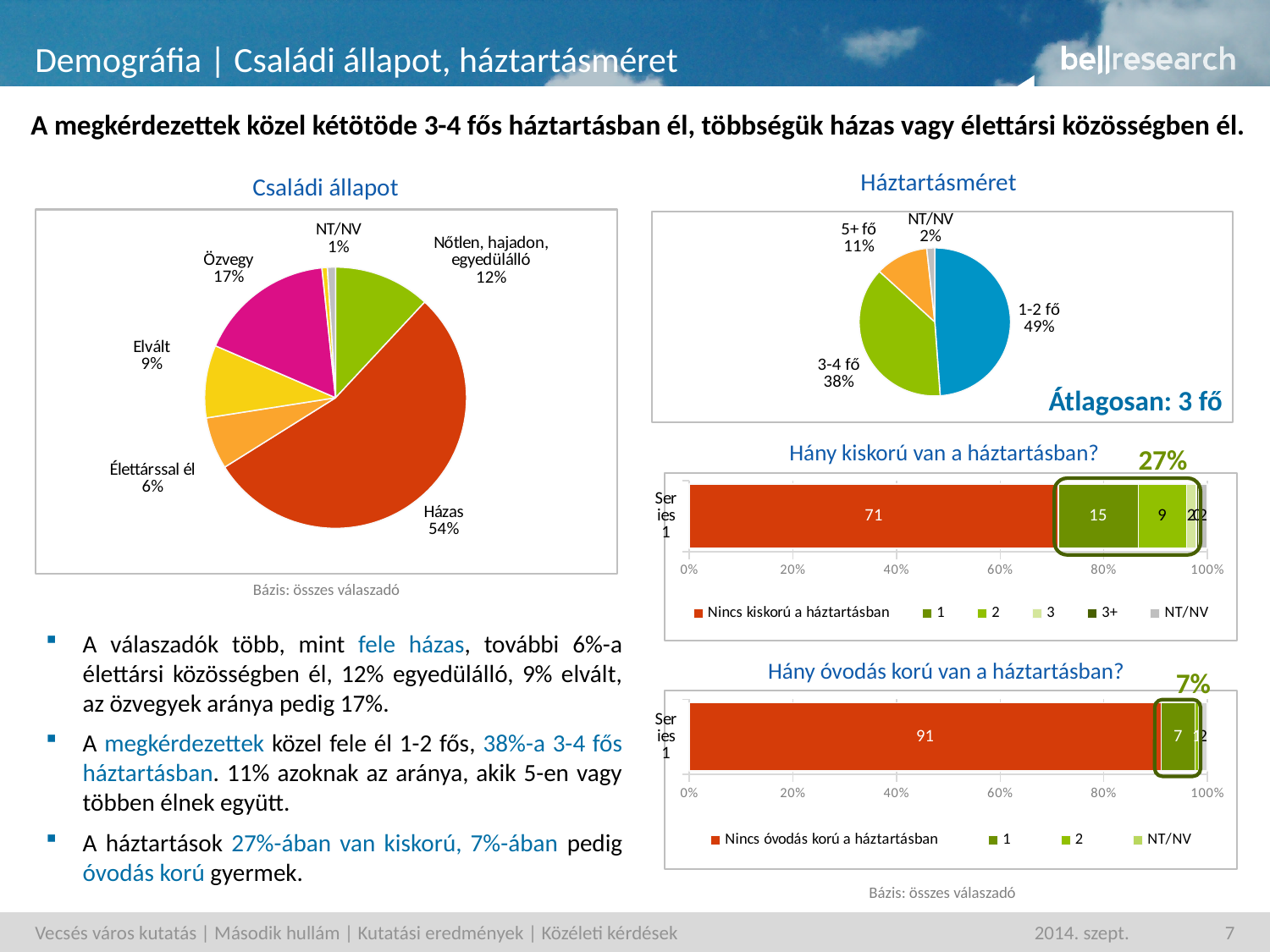
In the 'Családi állapot' pie chart, which category has the largest slice? Házas In the 'Családi állapot' pie chart, what is the difference in percentage points between 'Özvegy' and 'Elvált'? 8 How many series does the legend of the 'Hány kiskorú van a háztartásban?' chart list? 6 In the 'Háztartásméret' pie chart, which is larger: '1-2 fő' or '5+ fő'? 1-2 fő In the 'Hány kiskorú van a háztartásban?' chart, what value is shown for 'Nincs kiskorú a háztartásban'? 71 What type of chart is 'Háztartásméret'? pie chart In the 'Családi állapot' pie chart, what share is labelled for 'Házas'? 54% In the 'Hány óvodás korú van a háztartásban?' chart, what value is shown for 'Nincs óvodás korú a háztartásban'? 91 In the 'Háztartásméret' pie chart, what share is labelled for '3-4 fő'? 38% How many slices does the 'Családi állapot' pie chart have? 7 What type of chart is 'Hány óvodás korú van a háztartásban?'? stacked bar chart